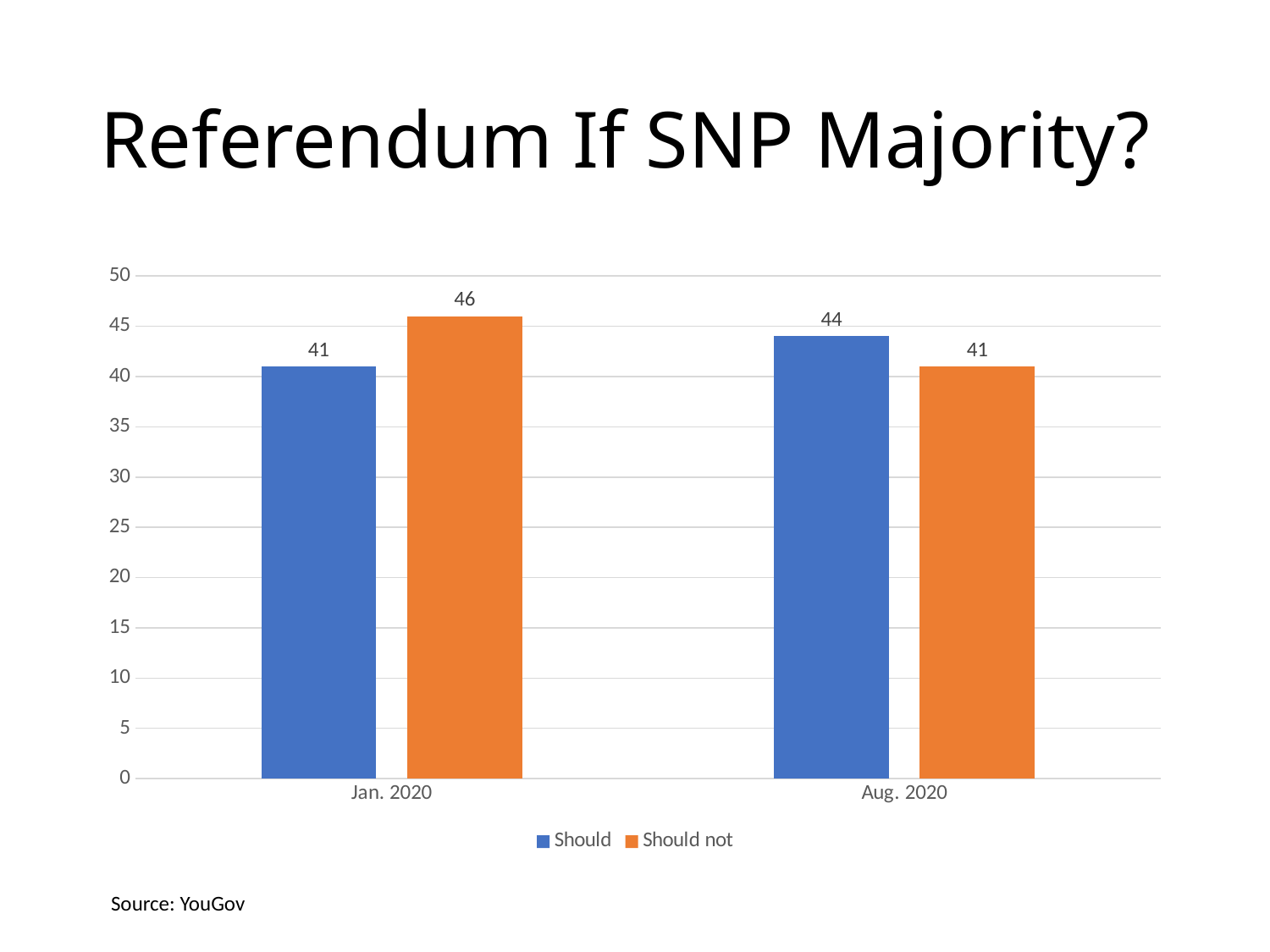
What is the value for "Should not" in Aug. 2020? 41 How many series does the legend list? 2 What is the difference between "Should" and "Should not" in Aug. 2020? 3 What is the value for "Should" in Aug. 2020? 44 What kind of chart is shown on the slide? Bar chart In Aug. 2020, which is larger: "Should" or "Should not"? Should How many categories are shown on the x axis? 2 What is the difference between "Should not" and "Should" in Jan. 2020? 5 Which bar has the highest value on the chart? Should not, Jan. 2020 What is the value for "Should not" in Jan. 2020? 46 What is the value for "Should" in Jan. 2020? 41 Is the value for "Should not" in Jan. 2020 greater or less than 45? greater